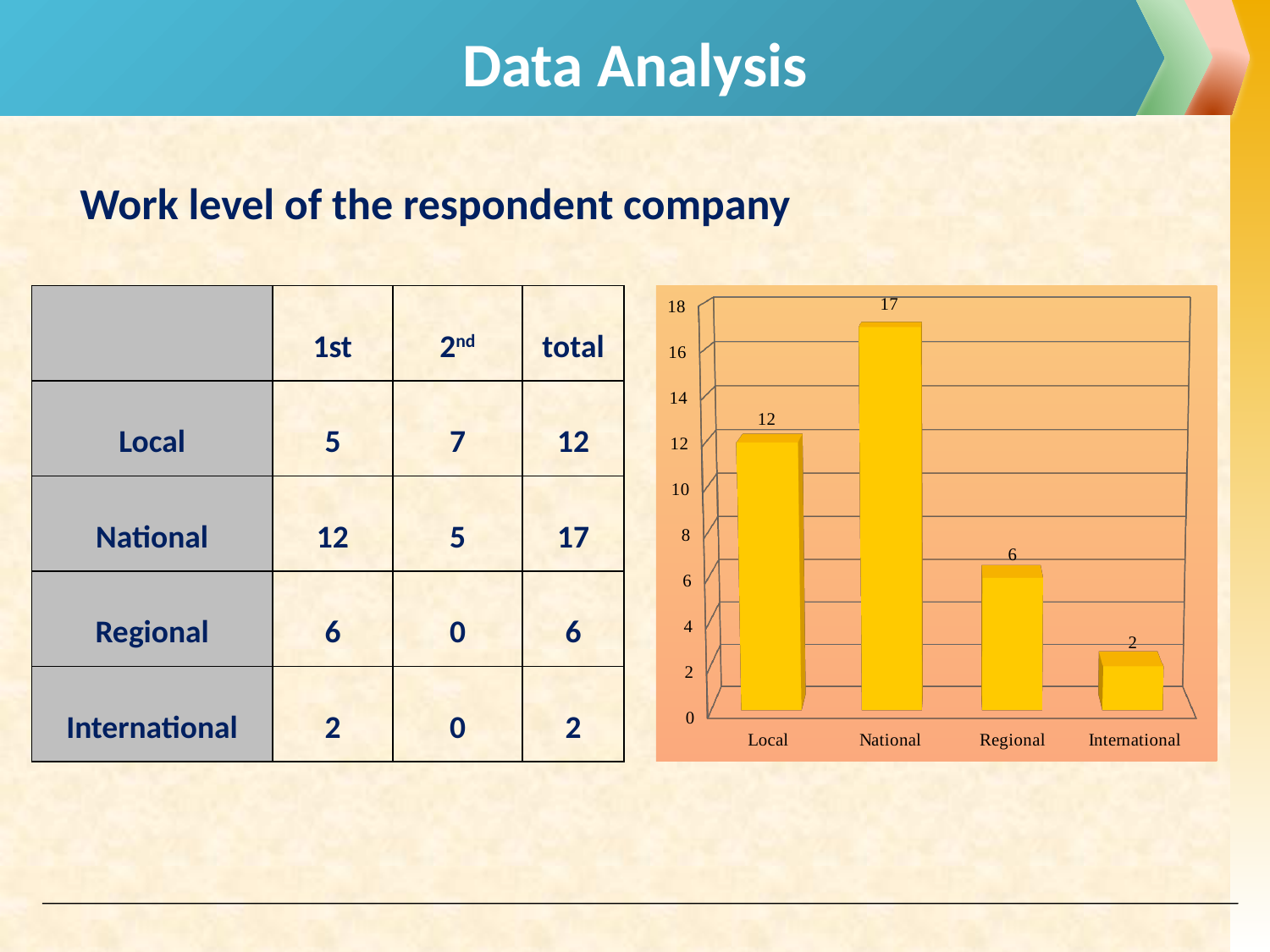
What kind of chart is shown on the slide? bar chart What is the difference between the values for Regional and International? 4 What is the value for Local in the chart? 12 How many categories are shown in the chart? 4 Which is larger, the value for Local or the value for Regional? Local What is the value for Regional in the chart? 6 What is the value for National in the chart? 17 What is the value for International in the chart? 2 Is the value for Regional greater or less than 10? less Which category has the lowest value in the chart? International Which category has the highest value in the chart? National What is the difference between the values for National and Local? 5